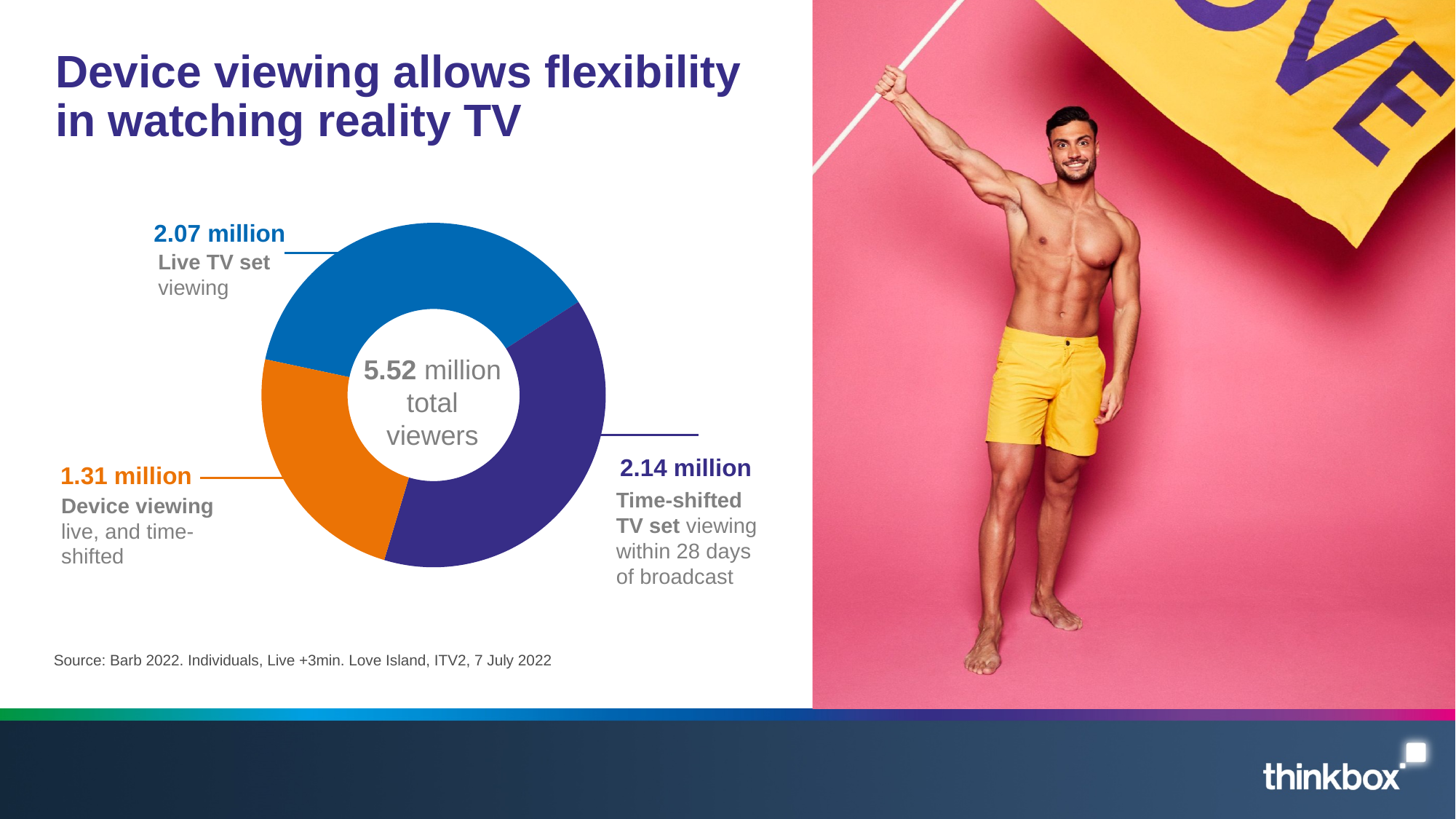
Which viewing category has the highest number of viewers? Time-shifted TV set viewing What is the value for Time-shifted TV set viewing within 28 days of broadcast? 2.14 million What is the value for Live TV set viewing? 2.07 million Which viewing category has the lowest number of viewers? Device viewing What is the difference between Time-shifted TV set viewing and Live TV set viewing? 0.07 million How many segments does the chart have? 3 What kind of chart is shown on the slide? Donut (pie) chart Which is larger, Live TV set viewing or Device viewing? Live TV set viewing What is the value for Device viewing (live, and time-shifted)? 1.31 million What colour is the Device viewing segment? Orange What is the total number of viewers shown in the centre of the chart? 5.52 million What is the difference between Live TV set viewing and Device viewing? 0.76 million